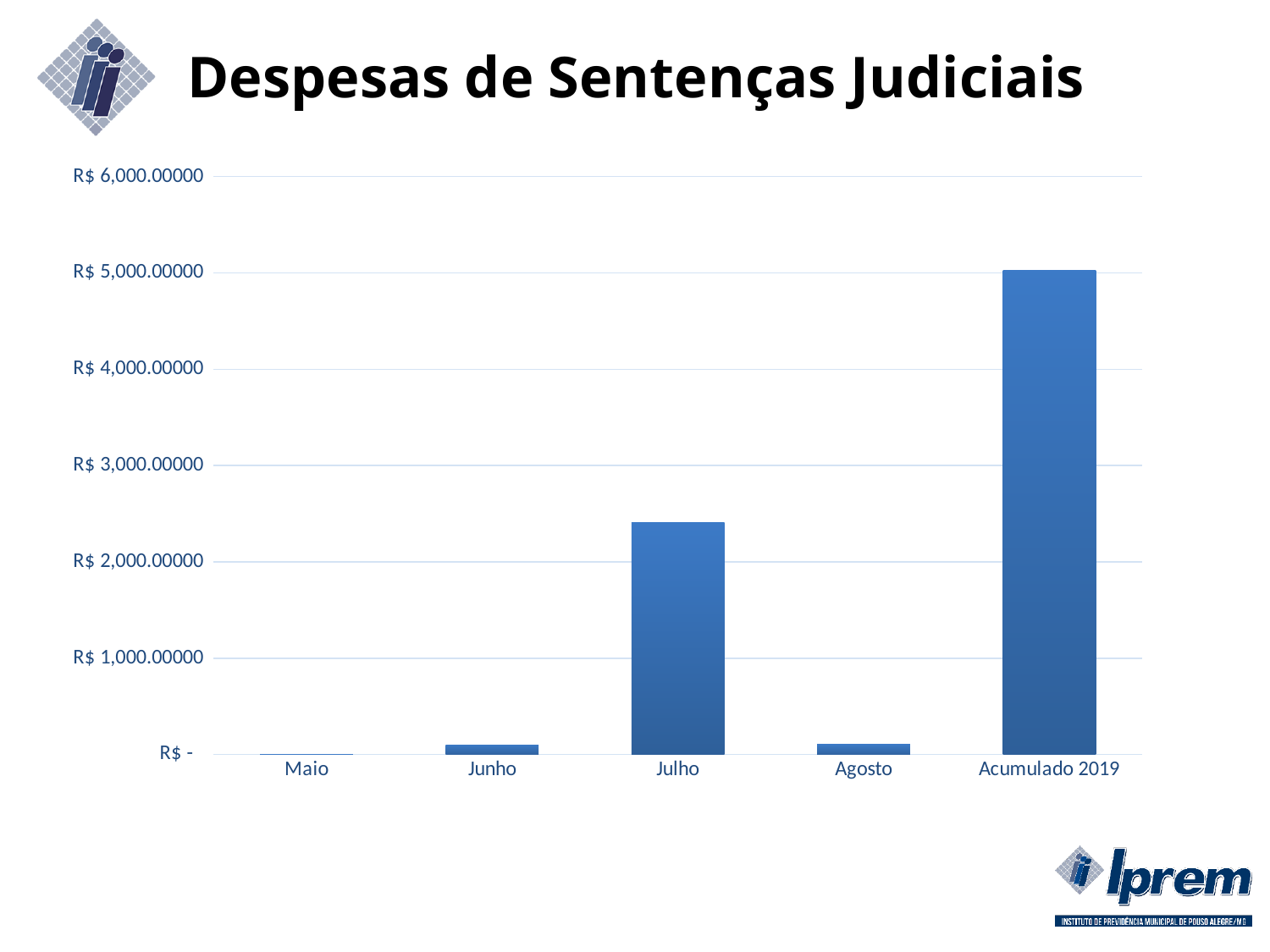
Is the value for Junho greater or less than R$ 1,000.00000? less Is the value for Acumulado 2019 greater or less than R$ 4,000.00000? greater Which category has the lowest value in the chart? Maio What is the title of the slide containing the chart? Despesas de Sentenças Judiciais Is the value for Julho greater or less than R$ 2,000.00000? greater Which is larger, the value for Acumulado 2019 or the value for Julho? Acumulado 2019 What kind of chart is shown on the slide? bar chart How many categories are shown on the x axis of the chart? 5 Which category has the highest value in the chart? Acumulado 2019 Which is larger, the value for Julho or the value for Agosto? Julho